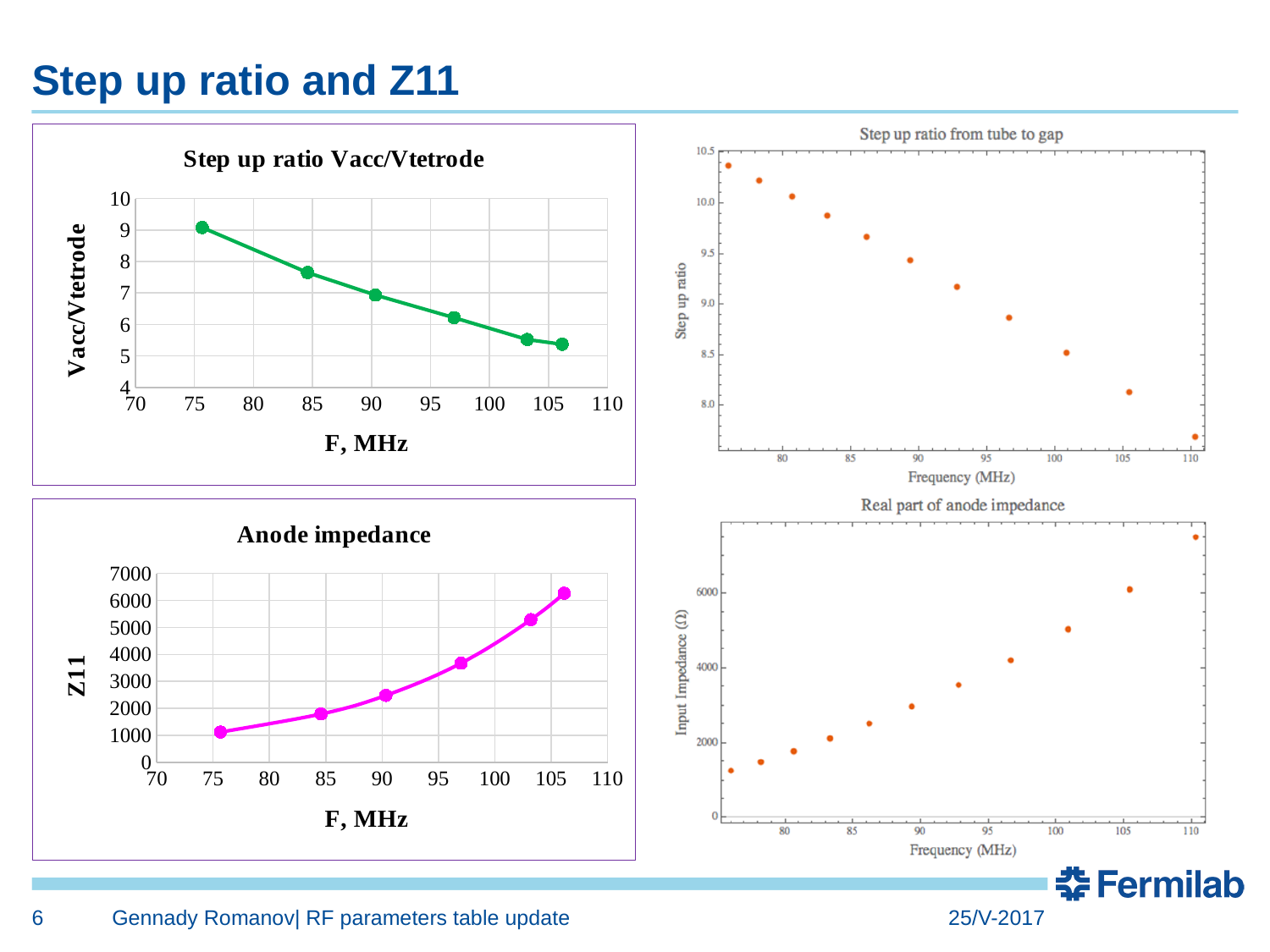
How many data points are plotted in the 'Step up ratio Vacc/Vtetrode' chart? 6 In the 'Anode impedance' chart, is the value at the highest frequency greater or less than 6000? greater In the 'Anode impedance' chart, which is larger: the value at the lowest frequency or the value at the highest frequency? the value at the highest frequency In the 'Step up ratio Vacc/Vtetrode' chart, is the value at the highest frequency greater or less than 6? less In the 'Step up ratio Vacc/Vtetrode' chart, do the values rise or fall as frequency increases? fall What kind of chart is the 'Step up ratio Vacc/Vtetrode' chart? line chart How many data points are plotted in the 'Anode impedance' chart? 6 In the 'Anode impedance' chart, is the value at the lowest frequency greater or less than 2000? less In the 'Anode impedance' chart, do the values rise or fall as frequency increases? rise What is the x-axis label of the 'Anode impedance' chart? F, MHz What is the title of the top-right chart on the slide? Step up ratio from tube to gap